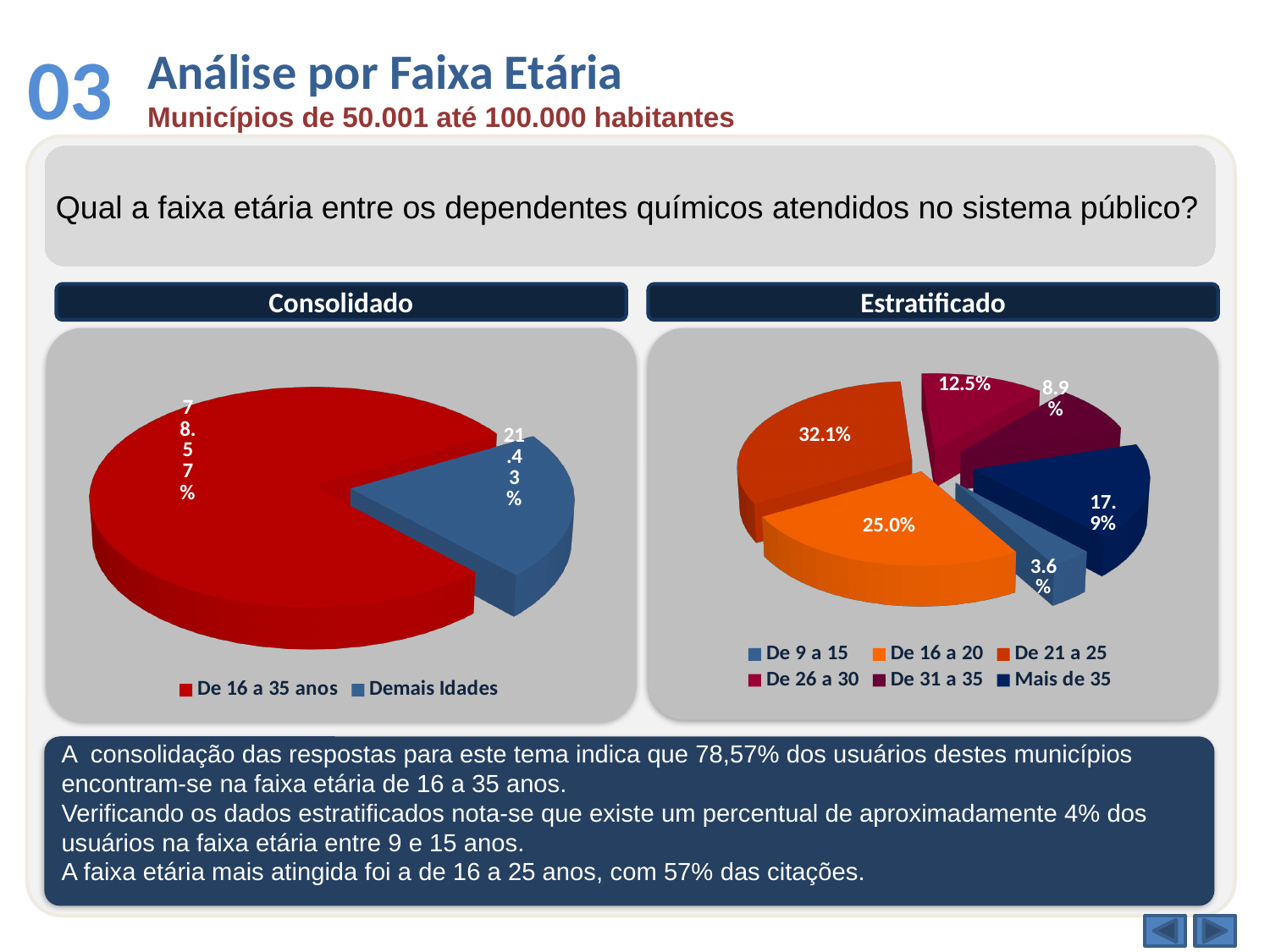
In the Estratificado chart, what is the value for De 21 a 25? 32.1% In the Consolidado chart, what is the value for De 16 a 35 anos? 78.57% In the Estratificado chart, what is the value for De 9 a 15? 3.6% What kind of chart is the Consolidado chart? Pie chart In the Estratificado chart, what is the difference between the values for De 21 a 25 and De 16 a 20? 7.1% In the Estratificado chart, what is the value for Mais de 35? 17.9% In the Estratificado chart, which is larger, De 26 a 30 or De 31 a 35? De 26 a 30 In the Estratificado chart, which category has the largest share? De 21 a 25 In the Consolidado chart, what is the value for Demais Idades? 21.43% In the Consolidado chart, what colour is the De 16 a 35 anos slice? Red How many categories does the Estratificado chart's legend list? 6 In the Estratificado chart, which category has the smallest share? De 9 a 15